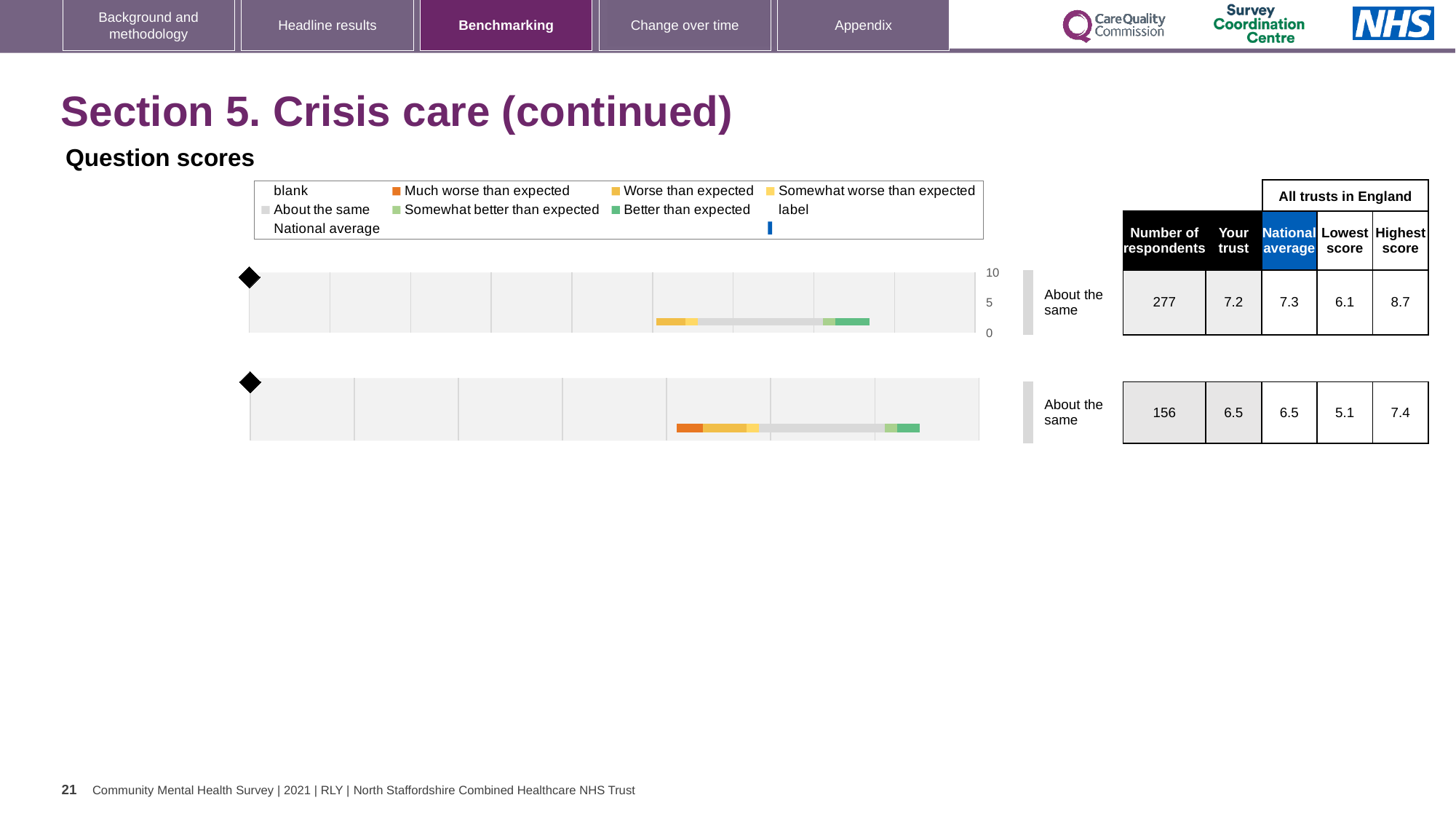
For the top chart, which is larger: the 'Your trust' score or the national average? National average For the bottom chart, how many respondents are shown in the table? 156 For the top chart, what is the difference between the highest score and the lowest score among all trusts in England? 2.6 For the top chart, what is the national average score? 7.3 For the top chart, what is the score for 'Your trust'? 7.2 For the top chart, what is the highest score among all trusts in England? 8.7 For the bottom chart, what is the difference between the highest score and the lowest score among all trusts in England? 2.3 For the top chart, how many respondents are shown in the table? 277 For the bottom chart, what is the lowest score among all trusts in England? 5.1 For the bottom chart, what is the score for 'Your trust'? 6.5 What benchmarking category label is shown next to the top chart? About the same What kind of chart is the top chart on the slide? bar chart